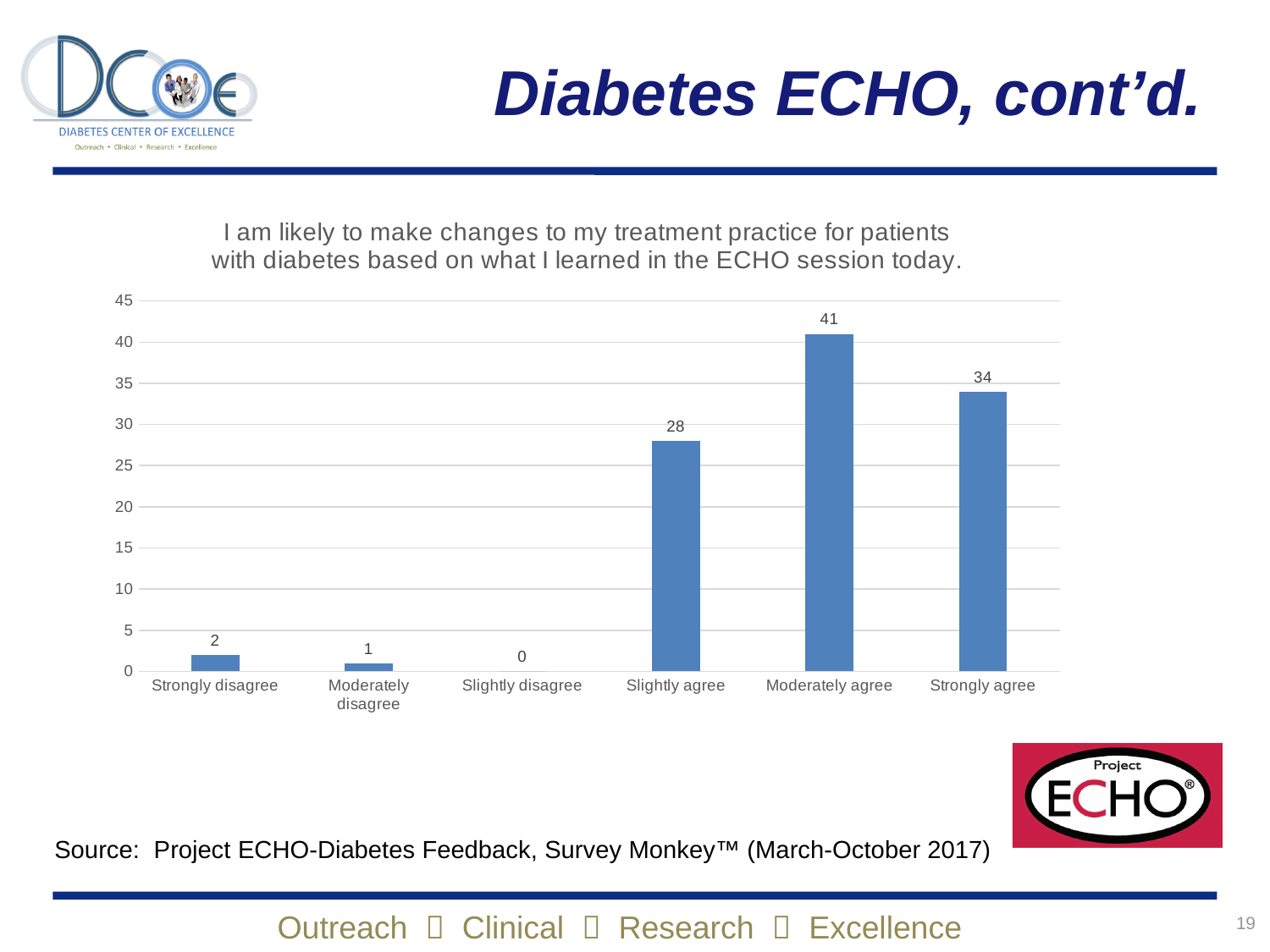
What is the title of the chart? I am likely to make changes to my treatment practice for patients with diabetes based on what I learned in the ECHO session today. What is the difference between the values for Moderately agree and Strongly agree? 7 Which is larger, the value for Slightly agree or the value for Strongly agree? Strongly agree What kind of chart is shown on the slide? bar chart Which category has the lowest value? Slightly disagree Is the value for Moderately agree greater or less than 40? greater What is the value for Strongly disagree? 2 What is the value for Slightly agree? 28 Which category has the highest value? Moderately agree What is the value for Moderately agree? 41 What is the value for Slightly disagree? 0 How many categories are shown on the x axis? 6